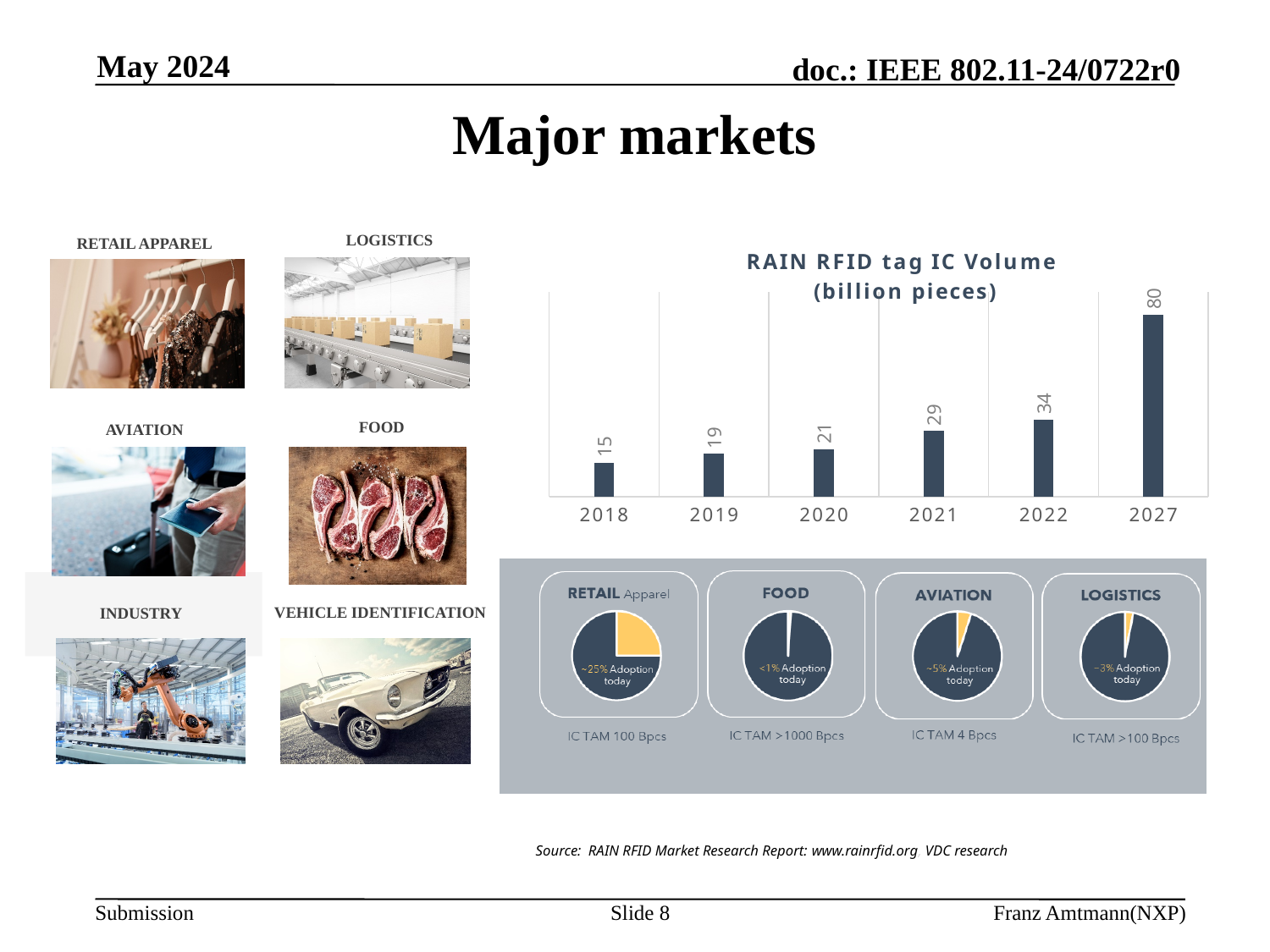
In the 'RAIN RFID tag IC Volume (billion pieces)' chart, which is larger, the value for 2020 or the value for 2021? 2021 In the 'RAIN RFID tag IC Volume (billion pieces)' chart, what is the value for 2021? 29 In the 'RAIN RFID tag IC Volume (billion pieces)' chart, what is the difference between the values for 2022 and 2019? 15 In the 'RAIN RFID tag IC Volume (billion pieces)' chart, do the values rise or fall from 2018 to 2027? rise What unit is given in the title of the bar chart on the right of the slide? billion pieces In the 'RAIN RFID tag IC Volume (billion pieces)' chart, what is the value for 2027? 80 In the 'RAIN RFID tag IC Volume (billion pieces)' chart, which year has the highest value? 2027 In the 'RAIN RFID tag IC Volume (billion pieces)' chart, which year has the lowest value? 2018 What kind of chart is the 'RAIN RFID tag IC Volume (billion pieces)' chart? bar chart How many years are shown on the x axis of the 'RAIN RFID tag IC Volume (billion pieces)' chart? 6 In the 'RAIN RFID tag IC Volume (billion pieces)' chart, what is the value for 2018? 15 In the 'RAIN RFID tag IC Volume (billion pieces)' chart, what is the difference between the values for 2027 and 2022? 46